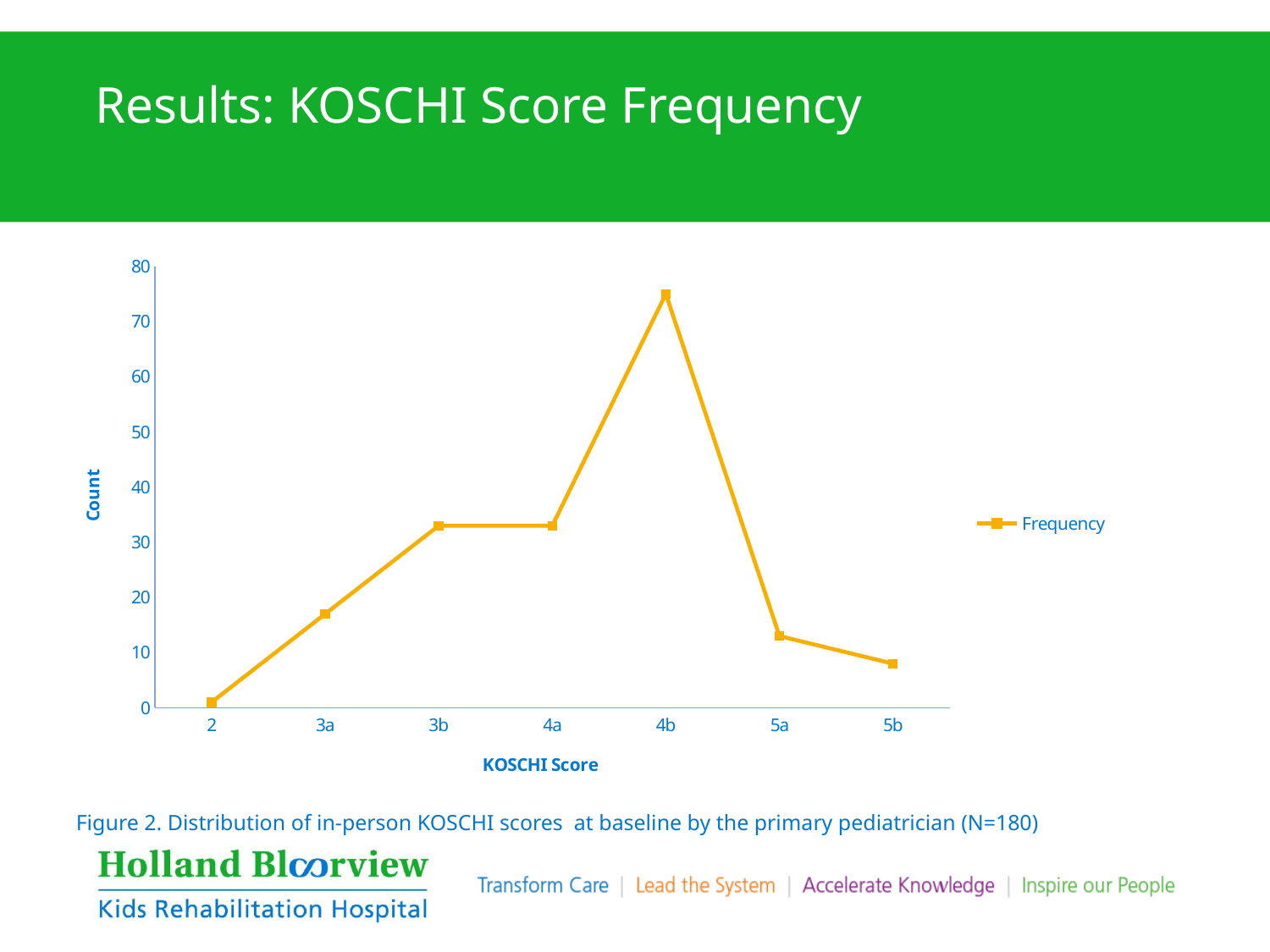
Is the value for KOSCHI score 5b greater or less than 10? less Does the frequency rise or fall from KOSCHI score 4b to 5a? Fall How many series does the legend list? 1 What kind of chart is shown on the slide? Line chart Is the value for KOSCHI score 3b greater or less than 30? greater Is the value for KOSCHI score 4b greater or less than 70? greater Which KOSCHI score has the lowest frequency? 2 Which KOSCHI score has the highest frequency? 4b Which has a higher frequency, KOSCHI score 3a or 5b? 3a What is the name of the series shown in the legend? Frequency How many KOSCHI score categories are plotted on the x axis? 7